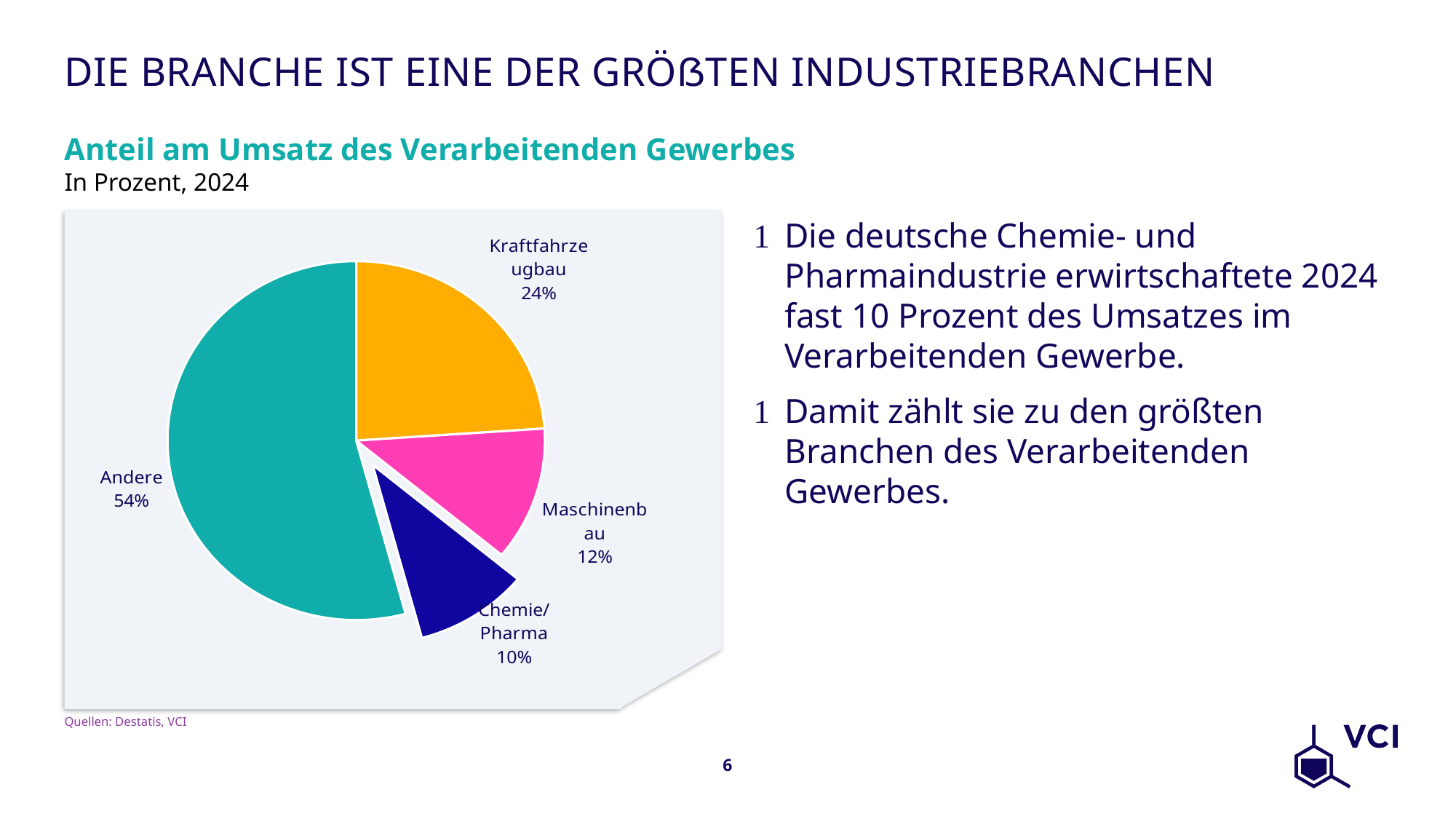
How many slices does the pie chart have? 4 What is the difference in percentage points between Kraftfahrzeugbau and Maschinenbau? 12 What share of the pie does Chemie/Pharma hold? 10% Which is larger, Maschinenbau or Chemie/Pharma? Maschinenbau What is the value shown for Maschinenbau? 12% What is the value shown for Kraftfahrzeugbau? 24% Which slice of the pie is the smallest? Chemie/Pharma Which slice is pulled out (exploded) from the pie? Chemie/Pharma What is the value shown for Andere? 54% Which slice of the pie is the largest? Andere What kind of chart is shown on the slide? Pie chart What is the title of the chart? Anteil am Umsatz des Verarbeitenden Gewerbes